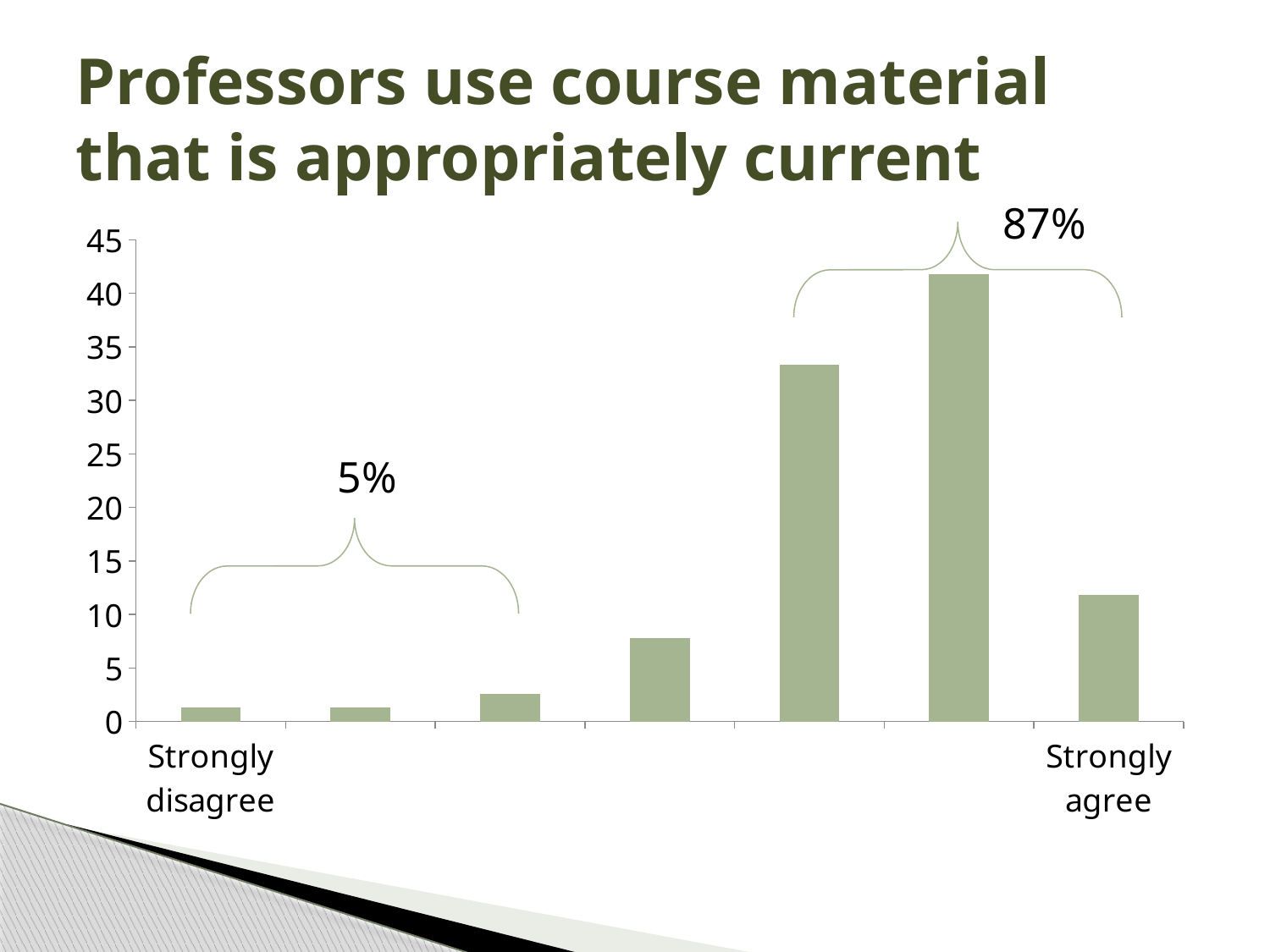
How many bars are plotted in the chart? 7 What is the title of the chart on the slide? Professors use course material that is appropriately current Which category has the lowest value, Strongly disagree or Strongly agree? Strongly disagree What kind of chart is shown on the slide? bar chart What percentage is written above the bracket spanning the three leftmost bars? 5% Is the value for Strongly disagree greater or less than 5? less Is the value for Strongly agree greater or less than 10? greater Is the value for Strongly agree greater or less than 15? less What is the highest value shown on the vertical axis? 45 Which is larger, the value for Strongly agree or the value for Strongly disagree? Strongly agree